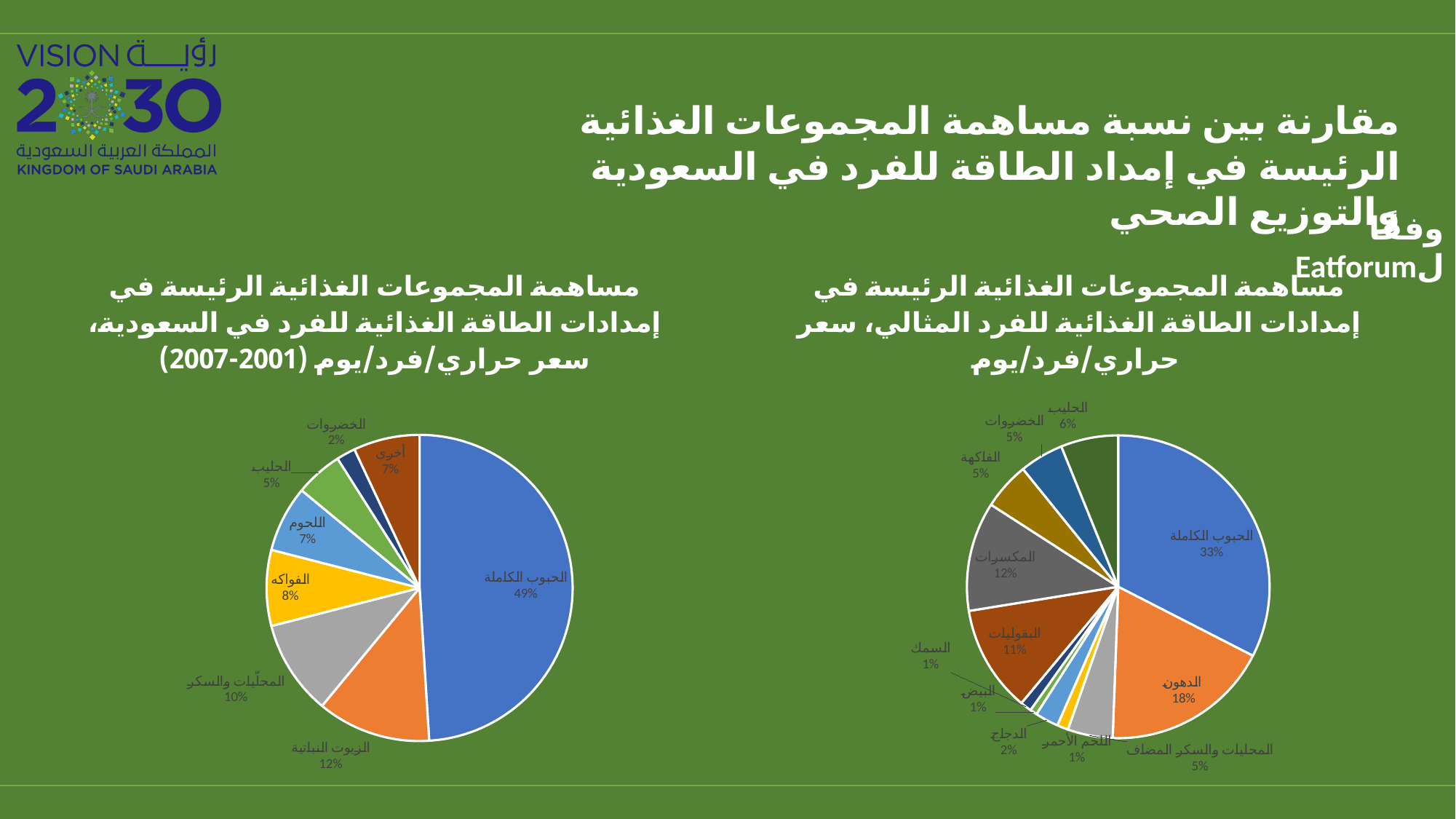
In the left pie chart (Saudi Arabia, 2001-2007), what share does الفواكه have? 8% In the left pie chart (Saudi Arabia, 2001-2007), what share does الحبوب الكاملة have? 49% How many categories are shown in the right pie chart (ideal individual)? 12 In the right pie chart (ideal individual), which is larger: المكسرات or البقوليات? المكسرات In the left pie chart (Saudi Arabia, 2001-2007), what is the difference between the shares of الحبوب الكاملة and الزيوت النباتية? 37% In the left pie chart (Saudi Arabia, 2001-2007), which category has the smallest share? الخضروات In the right pie chart (ideal individual), what share does الحبوب الكاملة have? 33% In the right pie chart (ideal individual), which category has the largest share? الحبوب الكاملة In the right pie chart (ideal individual), what share does الحليب have? 6% In the right pie chart (ideal individual), what share does الدهون have? 18% How many categories are shown in the left pie chart (Saudi Arabia, 2001-2007)? 8 What kind of charts are shown on the slide? Pie charts